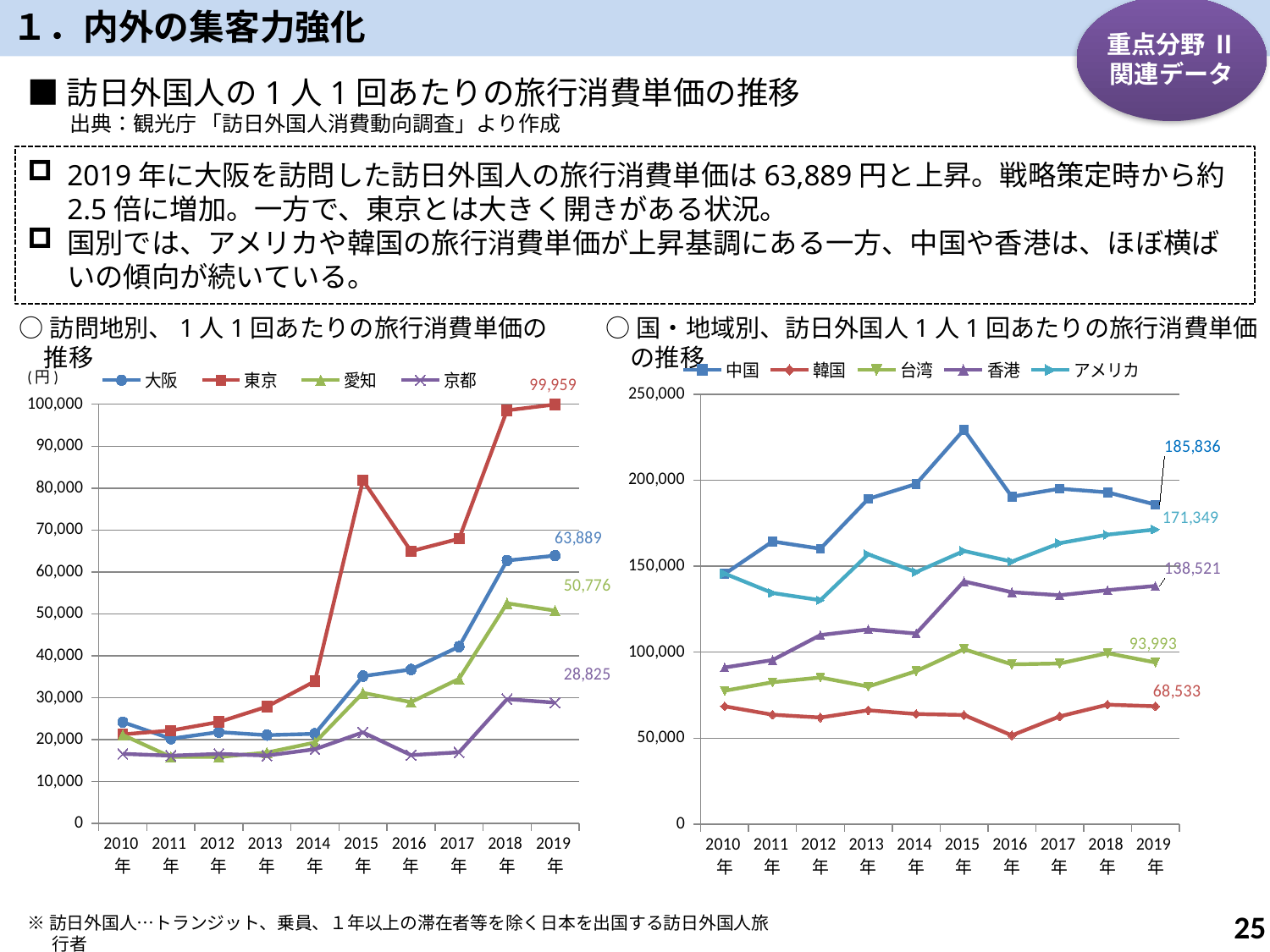
In the left chart (訪問地別), what is the value for 大阪 in 2019年? 63,889 In the left chart (訪問地別), which series has the highest value in 2019年? 東京 In the right chart (国・地域別), what is the value for 中国 in 2019年? 185,836 In the right chart (国・地域別), which series has the lowest value in 2019年? 韓国 In the right chart (国・地域別), what is the value for 韓国 in 2019年? 68,533 What kind of chart is the right chart (国・地域別)? line chart In the right chart (国・地域別), which is larger in 2019年, 香港 or 台湾? 香港 In the left chart (訪問地別), what is the value for 京都 in 2019年? 28,825 In the left chart (訪問地別), what is the difference between 東京 and 大阪 in 2019年? 36,070 In the left chart (訪問地別), how many series does the legend list? 4 In the left chart (訪問地別), what is the value for 東京 in 2019年? 99,959 In the left chart (訪問地別), is the value for 東京 in 2015年 greater or less than 70,000? greater